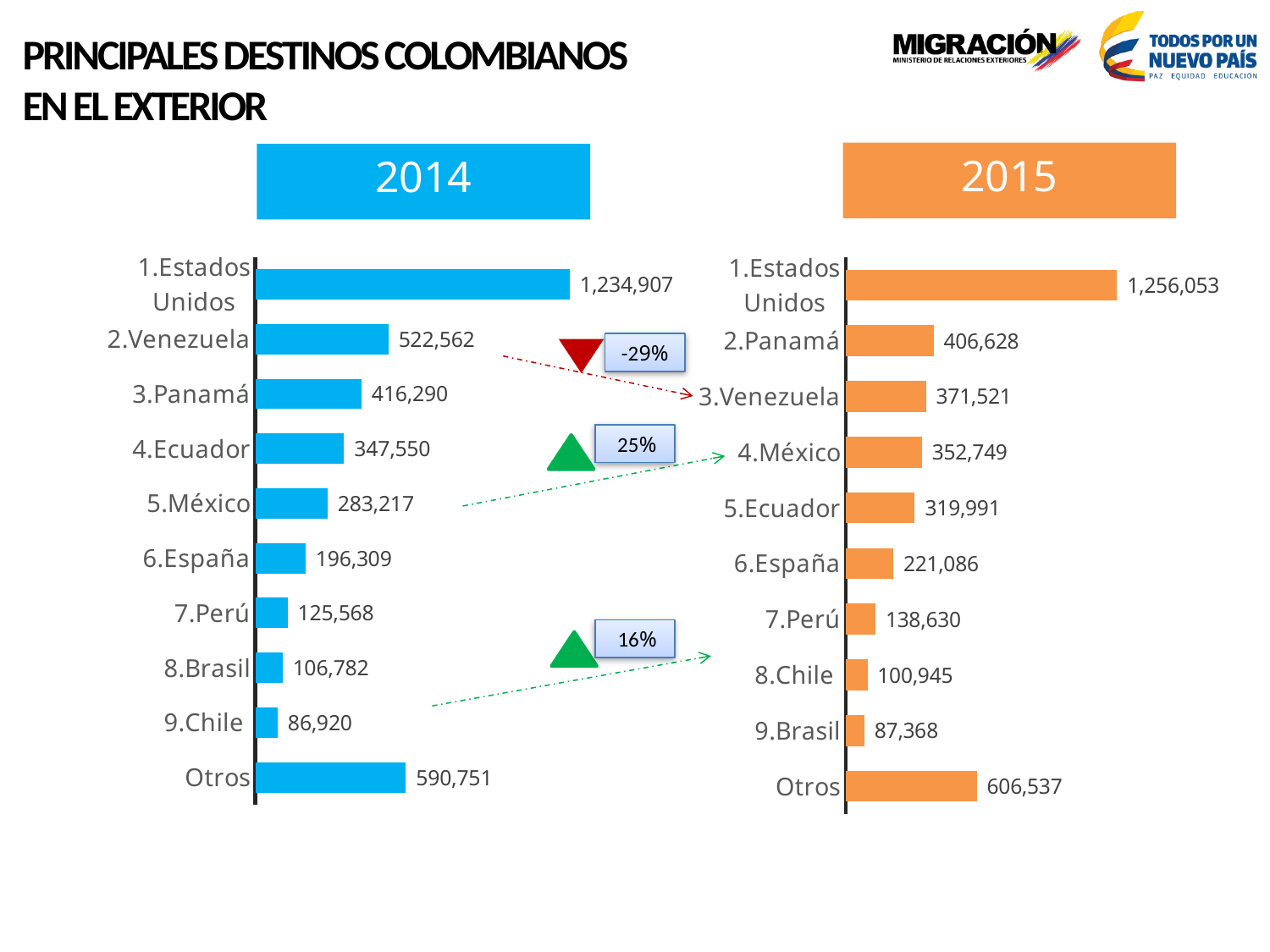
In the 2014 chart, what is the difference between the values for 3.Panamá and 4.Ecuador? 68,740 In the 2014 chart, which category has the lowest value? 9.Chile In the 2014 chart, what is the value for 2.Venezuela? 522,562 In the 2015 chart, what is the difference between the values for 1.Estados Unidos and Otros? 649,516 Which is larger: the value for 6.España in the 2014 chart or the value for 6.España in the 2015 chart? 6.España in the 2015 chart What kind of chart is the 2015 chart? Bar chart In the 2015 chart, which category has the lowest value? 9.Brasil In the 2015 chart, what is the value for 4.México? 352,749 In the 2015 chart, what is the value for 2.Panamá? 406,628 In the 2014 chart, which category has the highest value? 1.Estados Unidos What colour are the bars in the 2015 chart? Orange How many categories does the 2014 chart show? 10